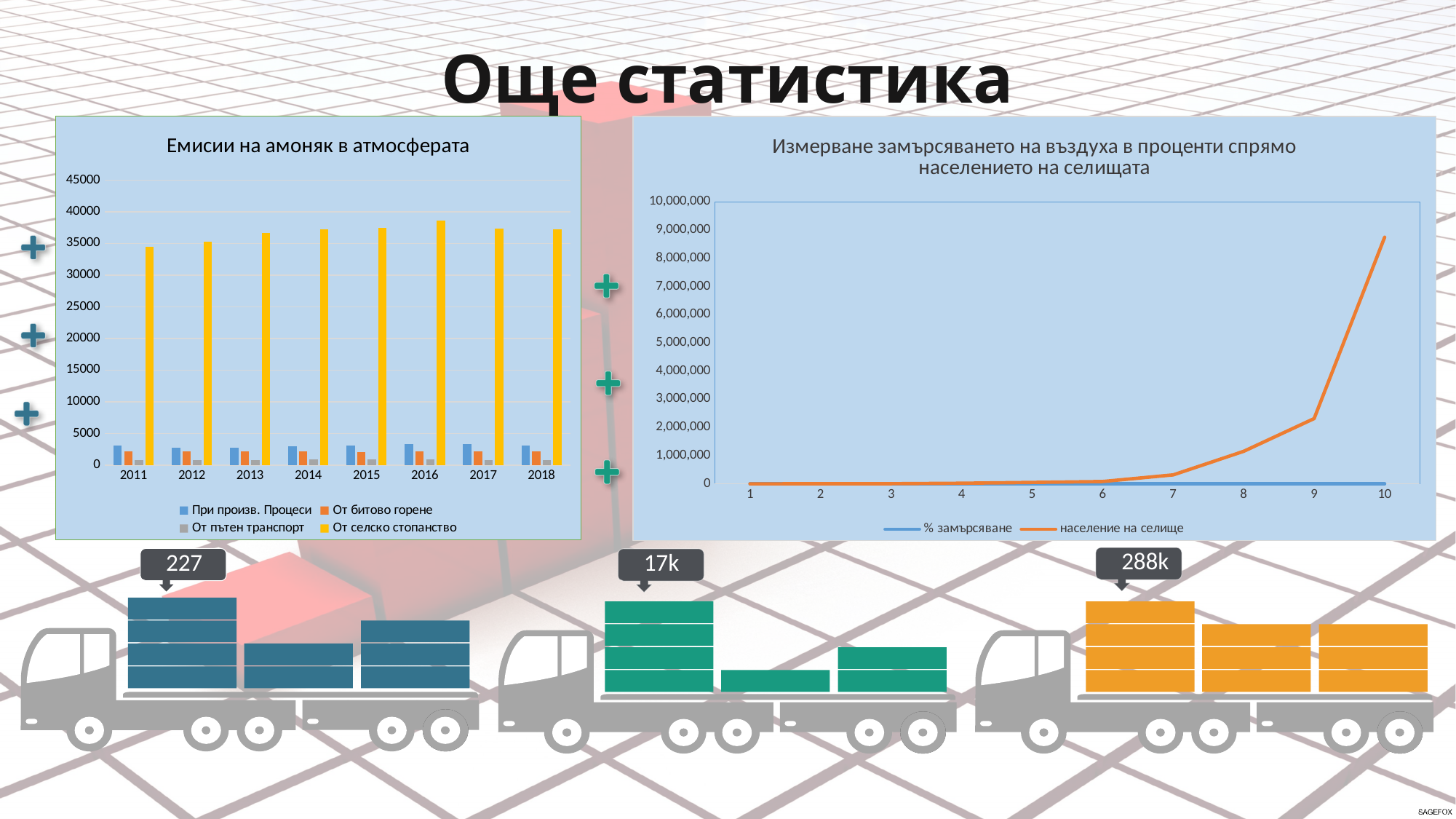
In the left chart "Емисии на амоняк в атмосферата", how many years are shown on the x axis? 8 In the left chart "Емисии на амоняк в атмосферата", which series is shown in yellow? От селско стопанство In the left chart "Емисии на амоняк в атмосферата", how many series does the legend list? 4 In the left chart "Емисии на амоняк в атмосферата", is the value for "От селско стопанство" in 2016 greater or less than 35000? greater In the right chart "Измерване замърсяването на въздуха в проценти спрямо населението на селищата", does the "население на селище" line rise or fall from point 1 to point 10? rise In the right chart "Измерване замърсяването на въздуха в проценти спрямо населението на селищата", is the value of "население на селище" at point 10 greater or less than 8,000,000? greater What kind of chart is the left chart titled "Емисии на амоняк в атмосферата"? bar chart In the left chart "Емисии на амоняк в атмосферата", in which year is the "От селско стопанство" bar the tallest? 2016 In the right chart "Измерване замърсяването на въздуха в проценти спрямо населението на селищата", how many series does the legend list? 2 What kind of chart is the right chart titled "Измерване замърсяването на въздуха в проценти спрямо населението на селищата"? line chart In the left chart "Емисии на амоняк в атмосферата", is the value for "От селско стопанство" in 2011 greater or less than 40000? less In the left chart "Емисии на амоняк в атмосферата", which series has the highest values in every year? От селско стопанство